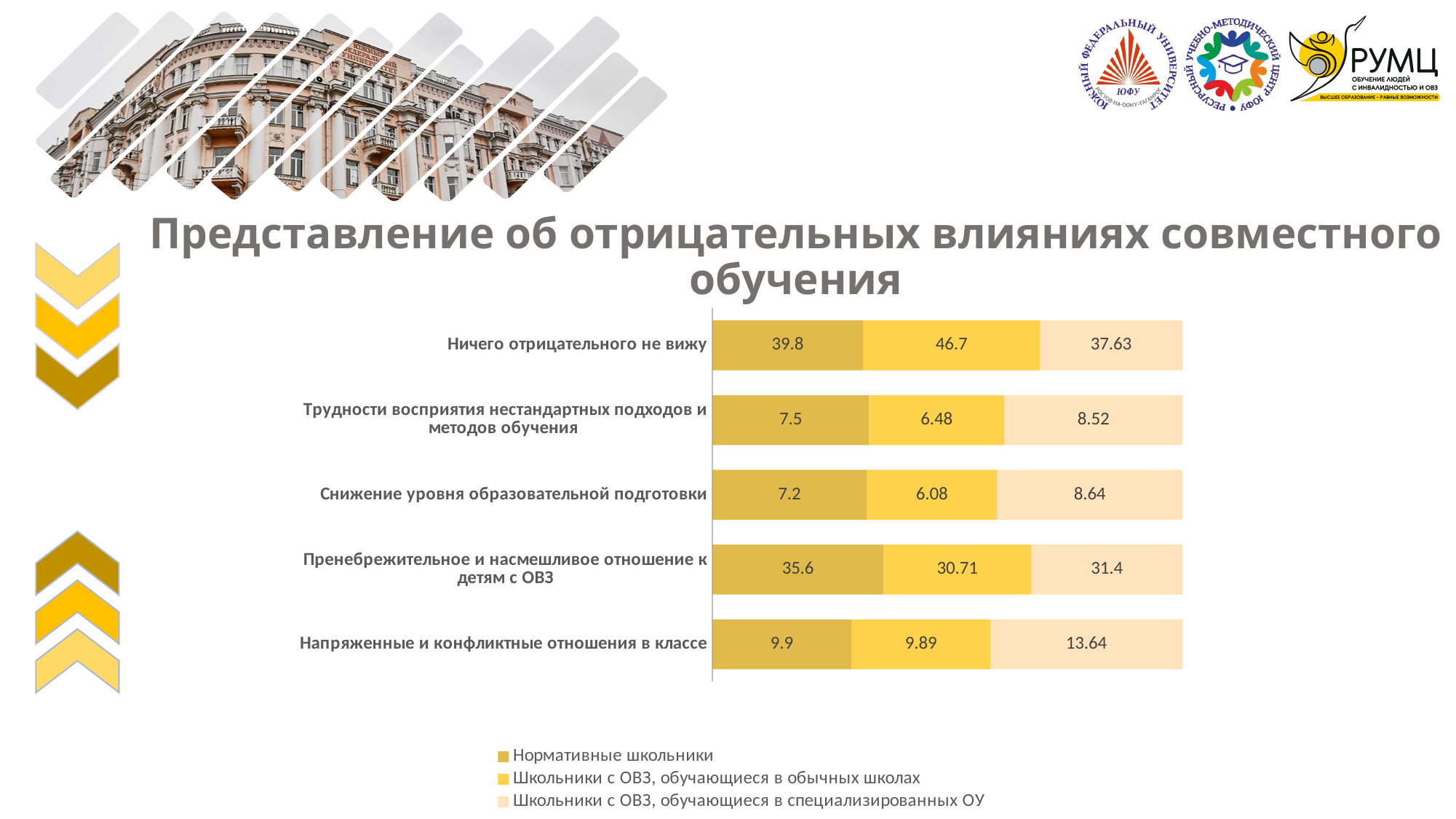
What is the difference between the "Школьники с ОВЗ, обучающиеся в обычных школах" value and the "Нормативные школьники" value in the category "Ничего отрицательного не вижу"? 6.9 What kind of chart is shown on the slide? Stacked bar chart Which series is shown in the lightest colour in the legend? Школьники с ОВЗ, обучающиеся в специализированных ОУ Which category has the highest value for "Нормативные школьники"? Ничего отрицательного не вижу In the category "Снижение уровня образовательной подготовки", which series has the larger value: "Нормативные школьники" or "Школьники с ОВЗ, обучающиеся в специализированных ОУ"? Школьники с ОВЗ, обучающиеся в специализированных ОУ What is the difference between the "Школьники с ОВЗ, обучающиеся в специализированных ОУ" value and the "Нормативные школьники" value in the category "Напряженные и конфликтные отношения в классе"? 3.74 What is the value for "Школьники с ОВЗ, обучающиеся в специализированных ОУ" in the category "Напряженные и конфликтные отношения в классе"? 13.64 What is the value for "Школьники с ОВЗ, обучающиеся в обычных школах" in the category "Пренебрежительное и насмешливое отношение к детям с ОВЗ"? 30.71 What is the value for "Нормативные школьники" in the category "Ничего отрицательного не вижу"? 39.8 Which category has the lowest value for "Школьники с ОВЗ, обучающиеся в обычных школах"? Снижение уровня образовательной подготовки How many categories are shown on the chart? 5 How many series does the legend list? 3